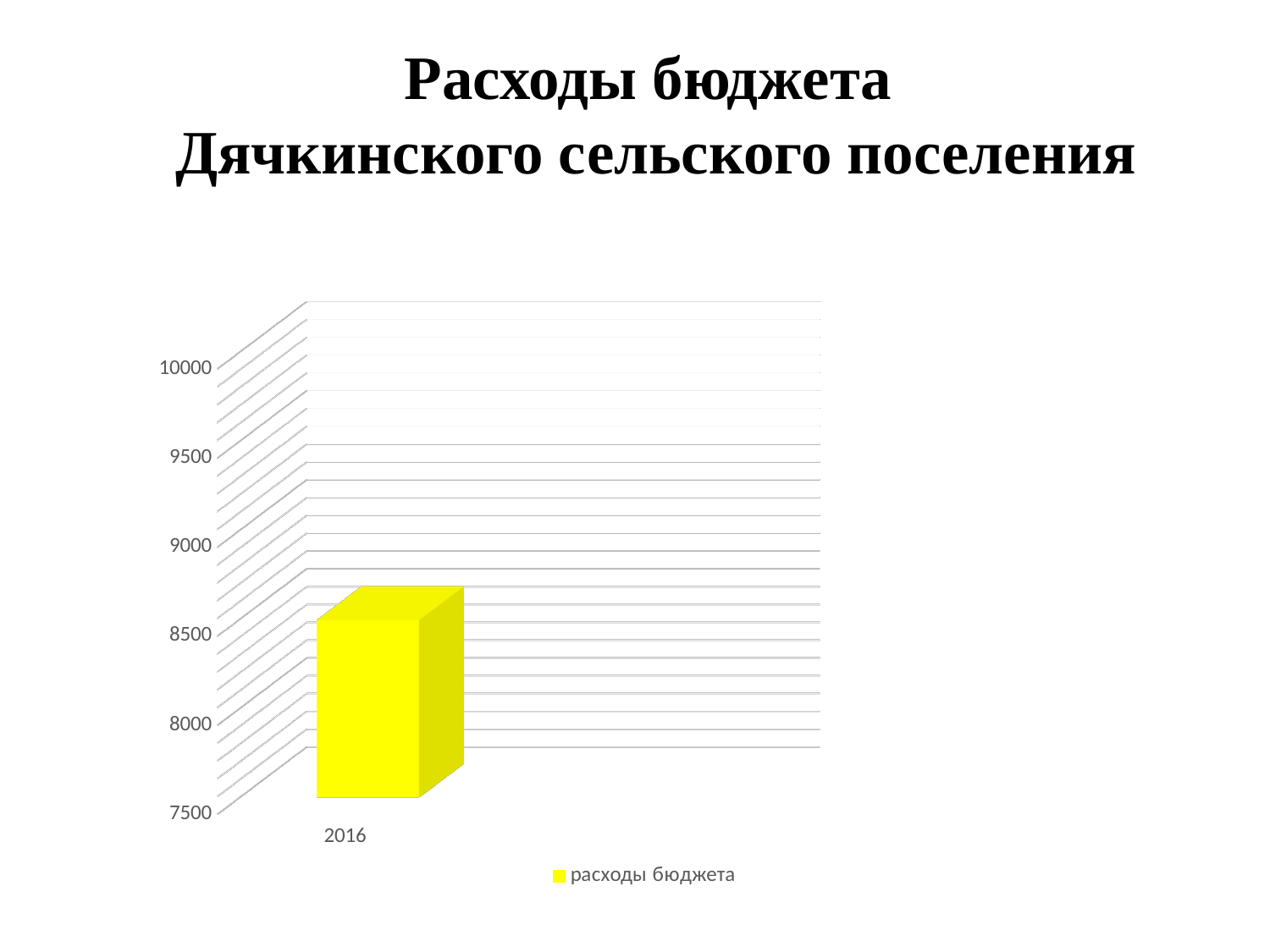
How many series does the chart legend list? 1 Which year is shown on the x axis of the chart? 2016 Is the value for 2016 greater or less than 7500? greater What kind of chart is shown on the slide? bar chart Is the value for 2016 greater or less than 8000? greater What is the name of the series shown in the chart legend? расходы бюджета Is the value for 2016 greater or less than 9500? less How many categories are plotted on the x axis of the chart? 1